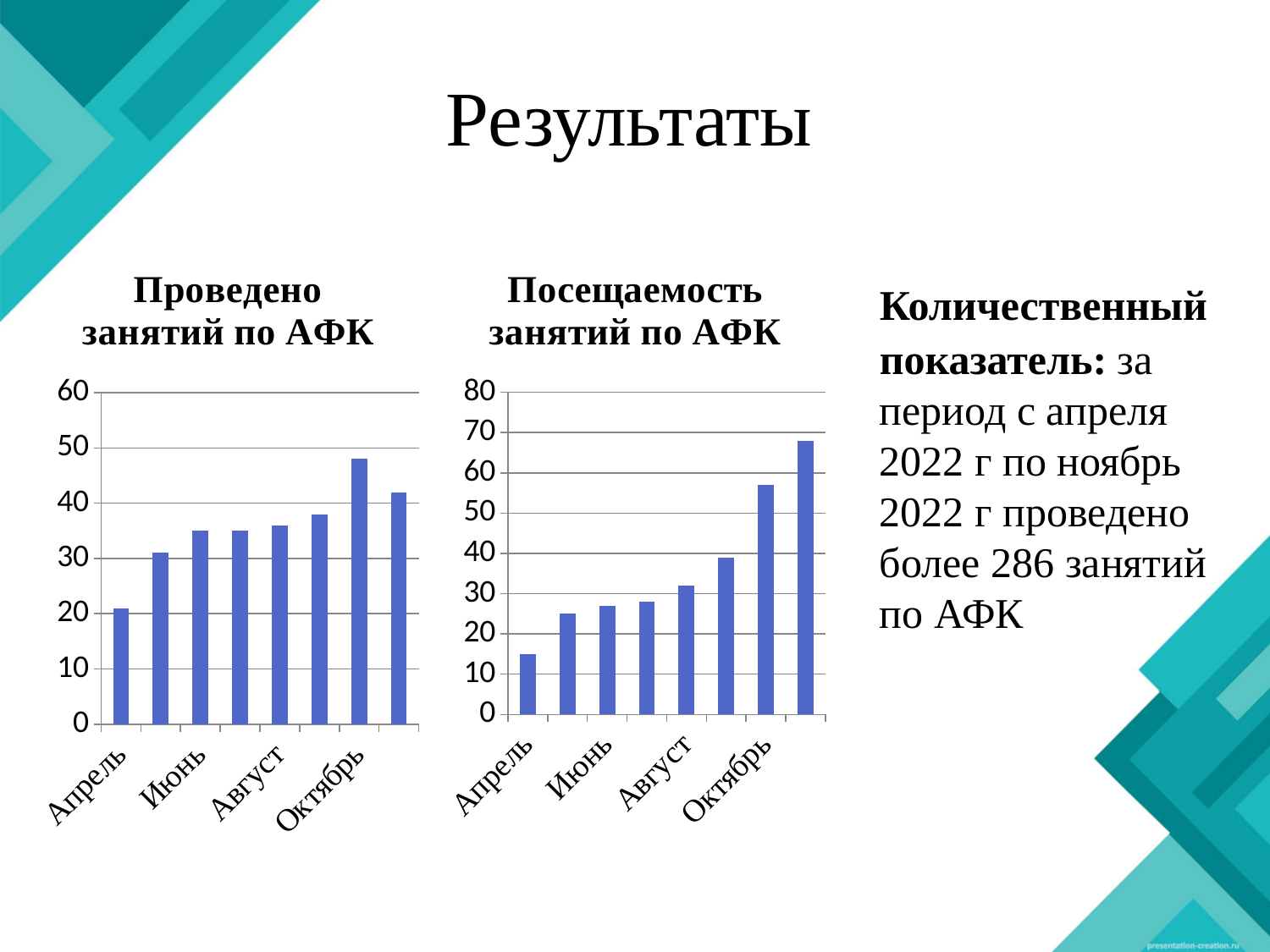
In the left chart "Проведено занятий по АФК", which is larger, the value for Апрель or the value for Август? Август In the right chart "Посещаемость занятий по АФК", do the values generally rise or fall from left to right along the x axis? rise In the left chart "Проведено занятий по АФК", is the value for Октябрь greater or less than 40? greater In the right chart "Посещаемость занятий по АФК", which is larger, the value for Июнь or the value for Октябрь? Октябрь In the right chart "Посещаемость занятий по АФК", is the value for Апрель greater or less than 20? less In the right chart "Посещаемость занятий по АФК", is the value for Октябрь greater or less than 50? greater What is the title of the right chart on the slide? Посещаемость занятий по АФК What kind of chart is the left chart titled "Проведено занятий по АФК"? bar chart How many bars does the right chart "Посещаемость занятий по АФК" have? 8 How many bars does the left chart "Проведено занятий по АФК" have? 8 In the left chart "Проведено занятий по АФК", which labelled month has the lowest value? Апрель